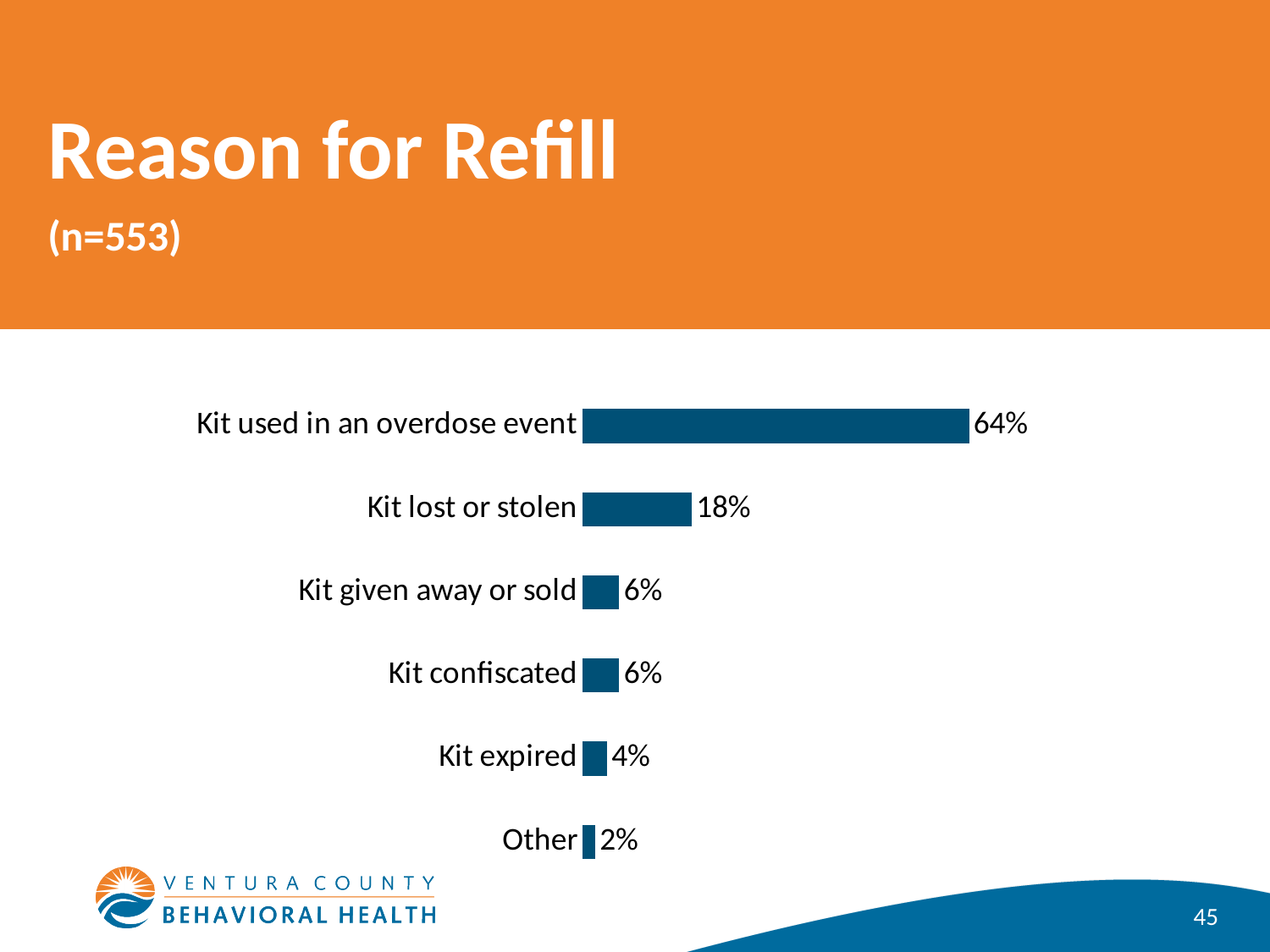
Which reason for refill has the lowest percentage? Other What is the title of the slide? Reason for Refill What is the sample size (n) given in the slide title? 553 What percentage is shown for 'Kit expired'? 4% What type of chart is shown on the slide? Bar chart What is the difference between 'Kit used in an overdose event' and 'Kit lost or stolen'? 46 percentage points What is the value for 'Kit lost or stolen'? 18% How many reason categories are shown in the chart? 6 Which is larger, 'Kit lost or stolen' or 'Kit given away or sold'? Kit lost or stolen What percentage of refills were because the kit was used in an overdose event? 64% Which reason for refill has the highest percentage? Kit used in an overdose event What is the value for the 'Other' category? 2%